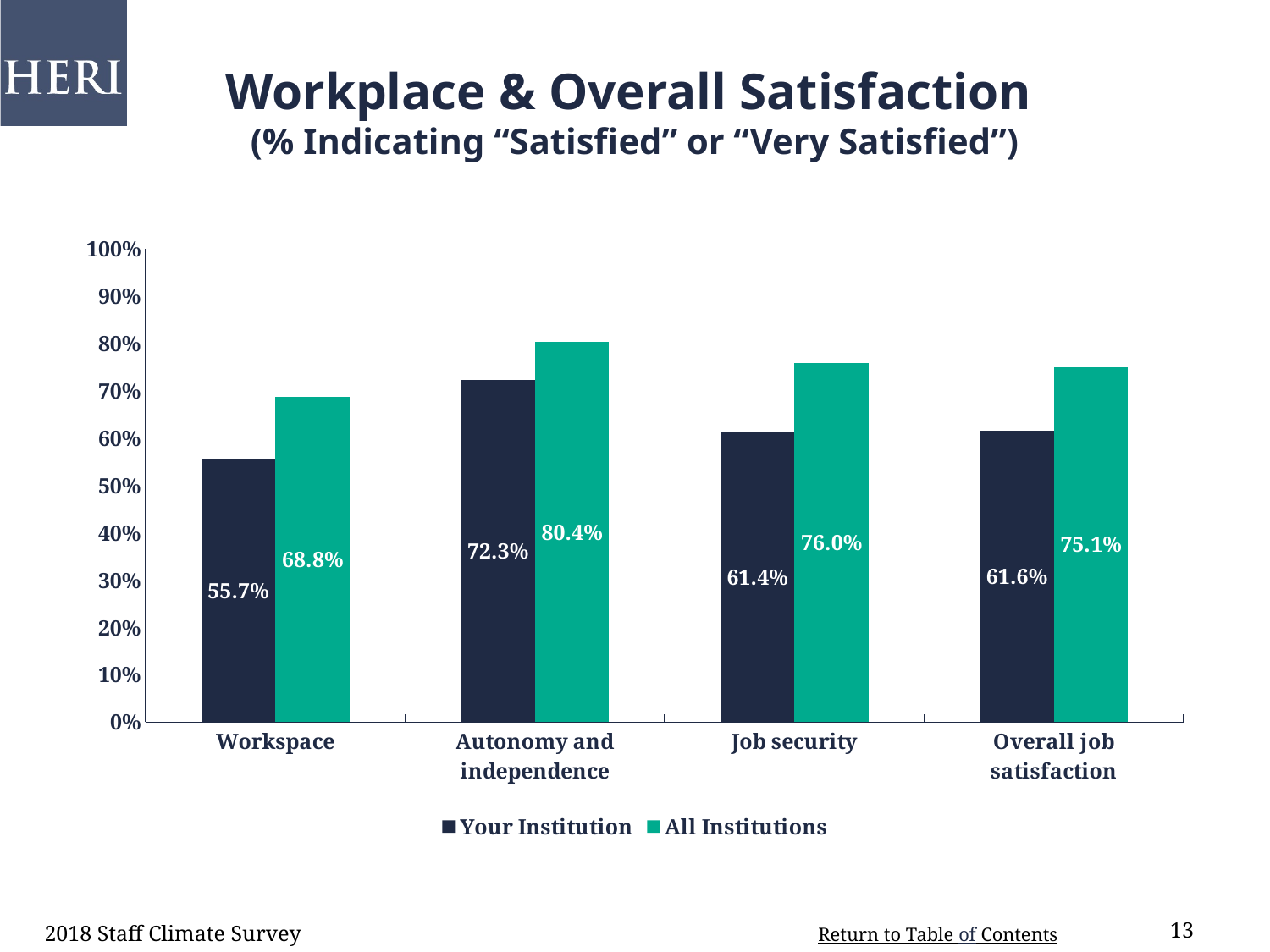
What is the value for All Institutions for Overall job satisfaction? 75.1% Which category has the highest value for Your Institution? Autonomy and independence What is the difference between All Institutions and Your Institution for Job security? 14.6% How many categories are shown on the x axis? 4 What is the value for Your Institution for Workspace? 55.7% What is the title of the chart? Workplace & Overall Satisfaction What kind of chart is shown on the slide? Bar chart How many series does the legend list? 2 Which category has the lowest value for All Institutions? Workspace Which is larger for Workspace: Your Institution or All Institutions? All Institutions What is the value for Your Institution for Job security? 61.4% What is the value for All Institutions for Autonomy and independence? 80.4%